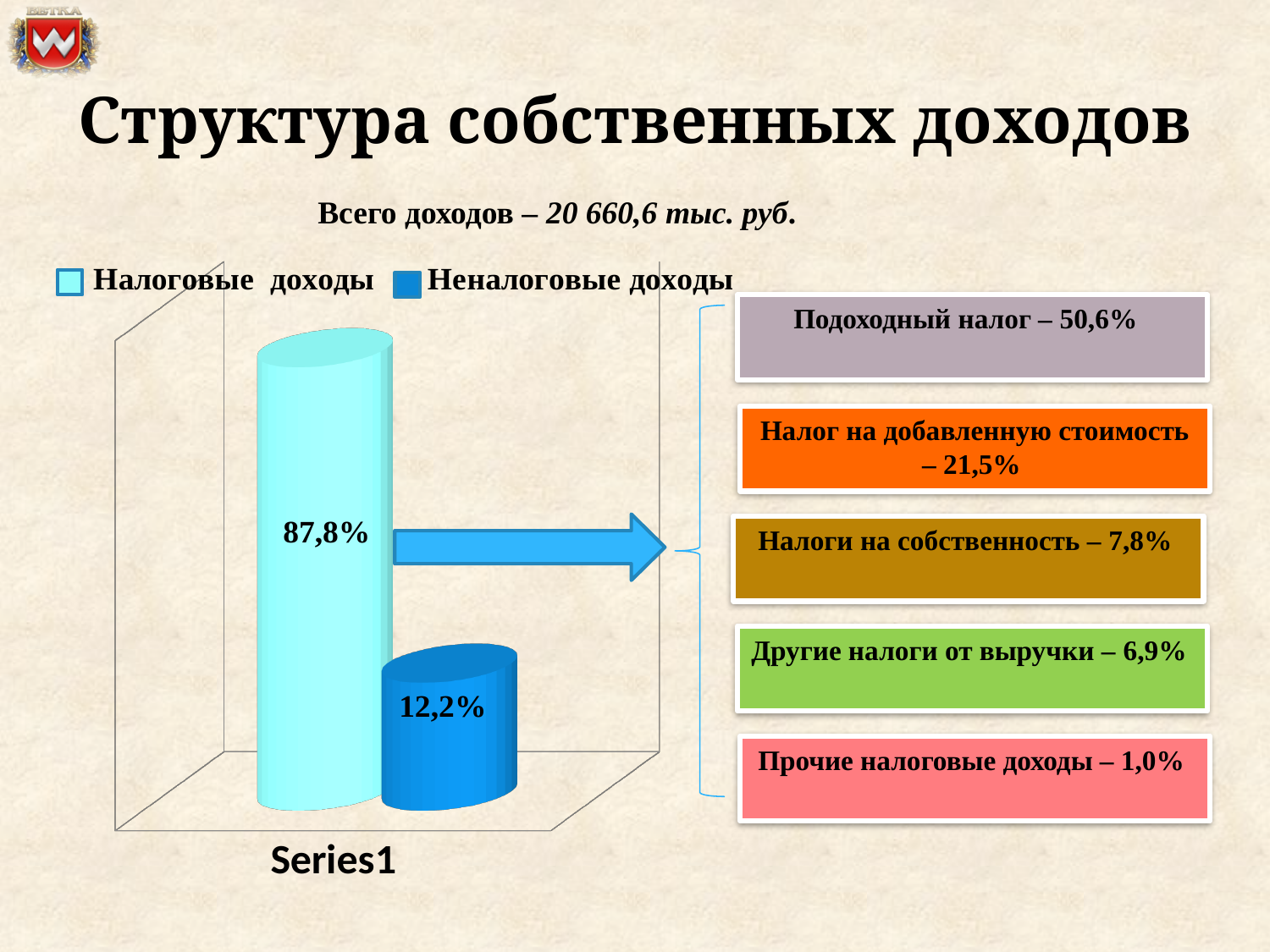
What is the value shown for Неналоговые доходы? 12,2% How many series does the legend list? 2 What is the total of the two values plotted on the chart? 100% What is the value shown for Налоговые доходы? 87,8% How many bars are plotted on the chart? 2 What kind of chart is shown on the slide? Bar chart What is the total income amount stated above the chart? 20 660,6 тыс. руб. Which series has the higher value, Налоговые доходы or Неналоговые доходы? Налоговые доходы What is the category label shown under the bars? Series1 What colour is the bar for Неналоговые доходы? Blue Which series has the lowest value on the chart? Неналоговые доходы What is the difference between the values for Налоговые доходы and Неналоговые доходы? 75,6%